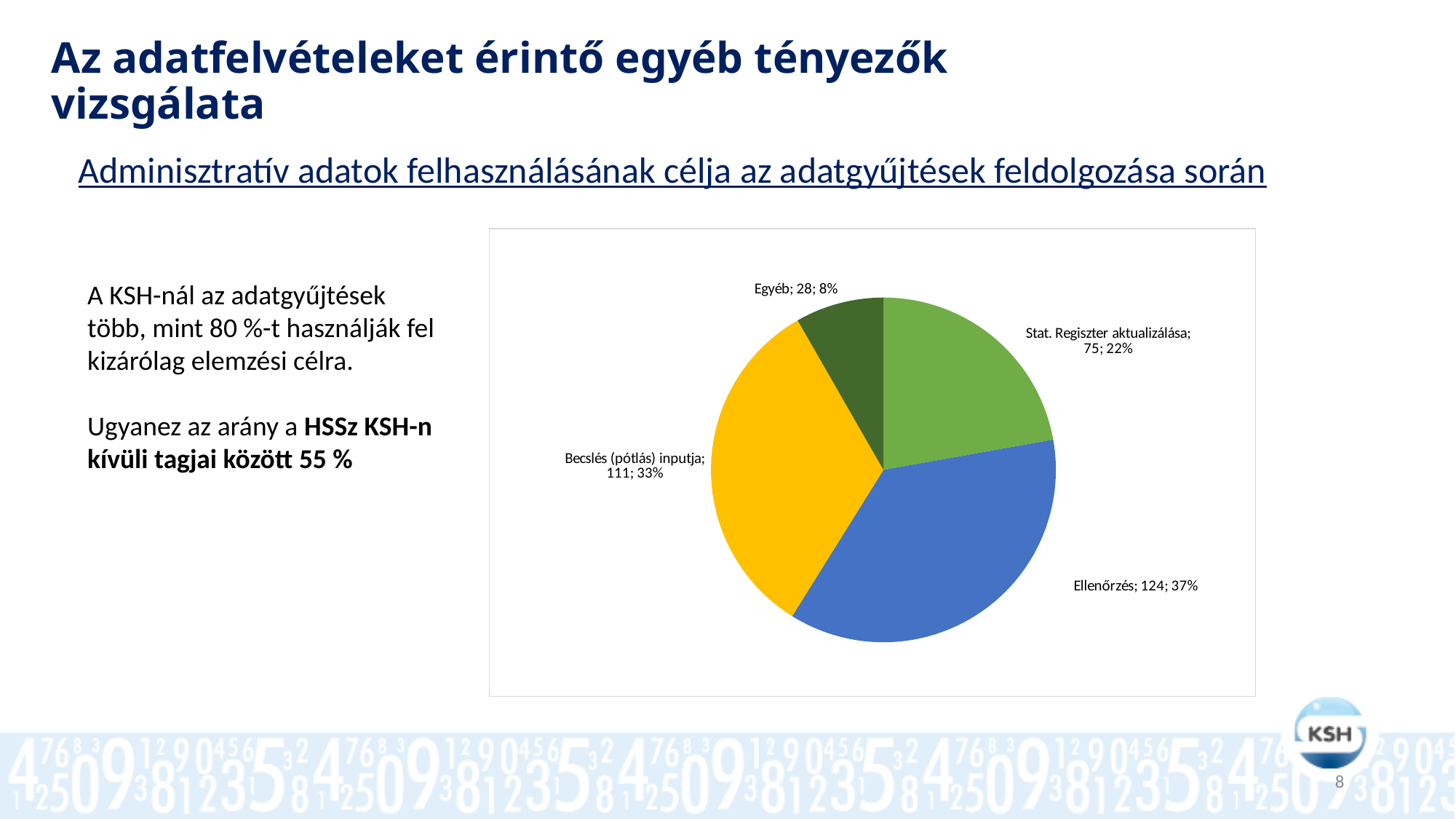
What colour is the Becslés (pótlás) inputja slice in the pie chart? yellow What percentage share does the Egyéb slice have? 8% What percentage share does the Ellenőrzés slice have? 37% Which category has the largest slice in the pie chart? Ellenőrzés What is the value for Stat. Regiszter aktualizálása in the pie chart? 75 What is the value for Becslés (pótlás) inputja in the pie chart? 111 Which is larger, the value for Stat. Regiszter aktualizálása or the value for Egyéb? Stat. Regiszter aktualizálása Which category has the smallest slice in the pie chart? Egyéb What is the value for Ellenőrzés in the pie chart? 124 What is the difference between the values for Ellenőrzés and Becslés (pótlás) inputja? 13 How many slices does the pie chart have? 4 What kind of chart is shown on the slide? pie chart